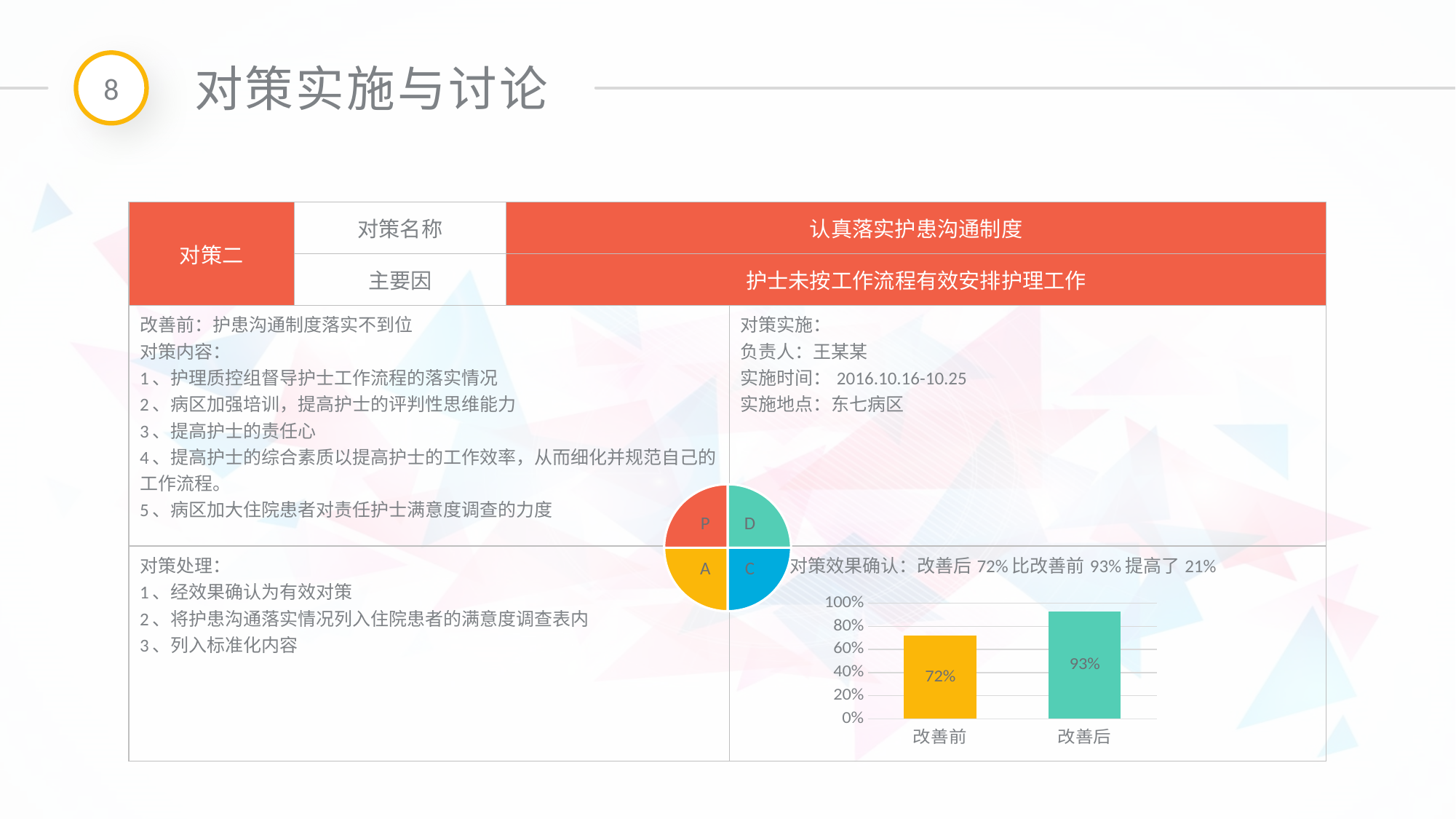
Do the values rise or fall from 改善前 to 改善后 in the bar chart? rise Is the value for 改善后 greater or less than 80%? greater Is the value for 改善前 larger or smaller than the value for 改善后? smaller Which category has the lower value in the bar chart? 改善前 How many categories are shown in the bar chart? 2 What is the difference between the 改善后 and 改善前 values in the bar chart? 21% Is the value for 改善前 greater or less than 80%? less Which category has the higher value in the bar chart? 改善后 What is the highest value shown on the vertical axis of the bar chart? 100% What is the value for 改善前 in the bar chart? 72% What kind of chart is shown at the bottom right of the slide? bar chart What is the value for 改善后 in the bar chart? 93%